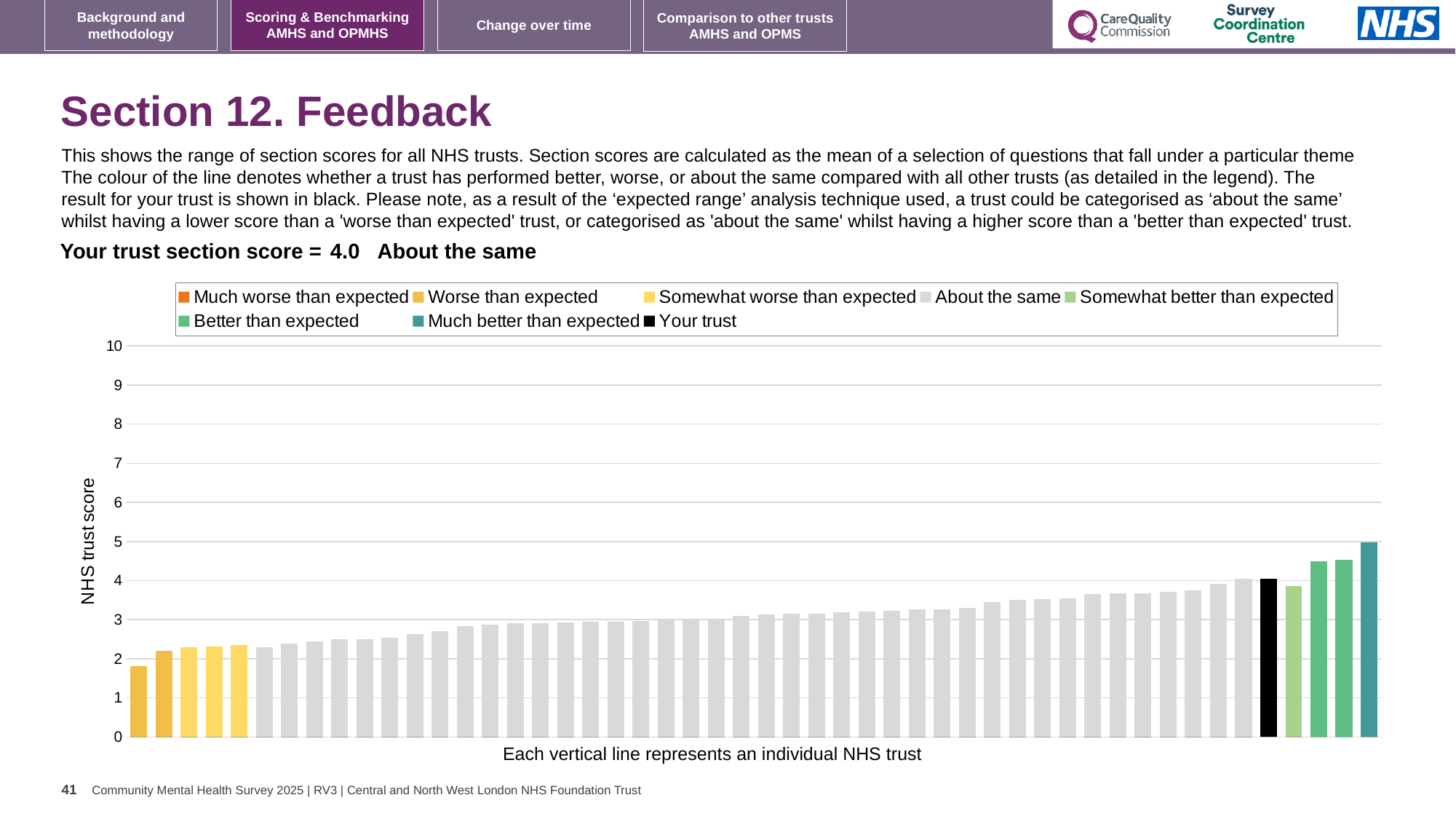
What is the label on the vertical axis of the chart? NHS trust score What kind of chart is shown on the slide? Bar chart Do the bar values rise or fall moving from left to right along the x axis? Rise Is the value of the tallest bar (rightmost, teal) greater or less than 4? greater Is the black 'Your trust' bar higher or lower than the leftmost bar? Higher What colour is used for the 'Your trust' bar according to the legend? Black Is the value of the leftmost bar greater or less than 2? less Is the value of the black 'Your trust' bar greater or less than 3? greater What is your trust's section score as printed on the slide? 4.0 Which category is your trust placed in according to the text above the chart? About the same How many entries does the chart legend list? 8